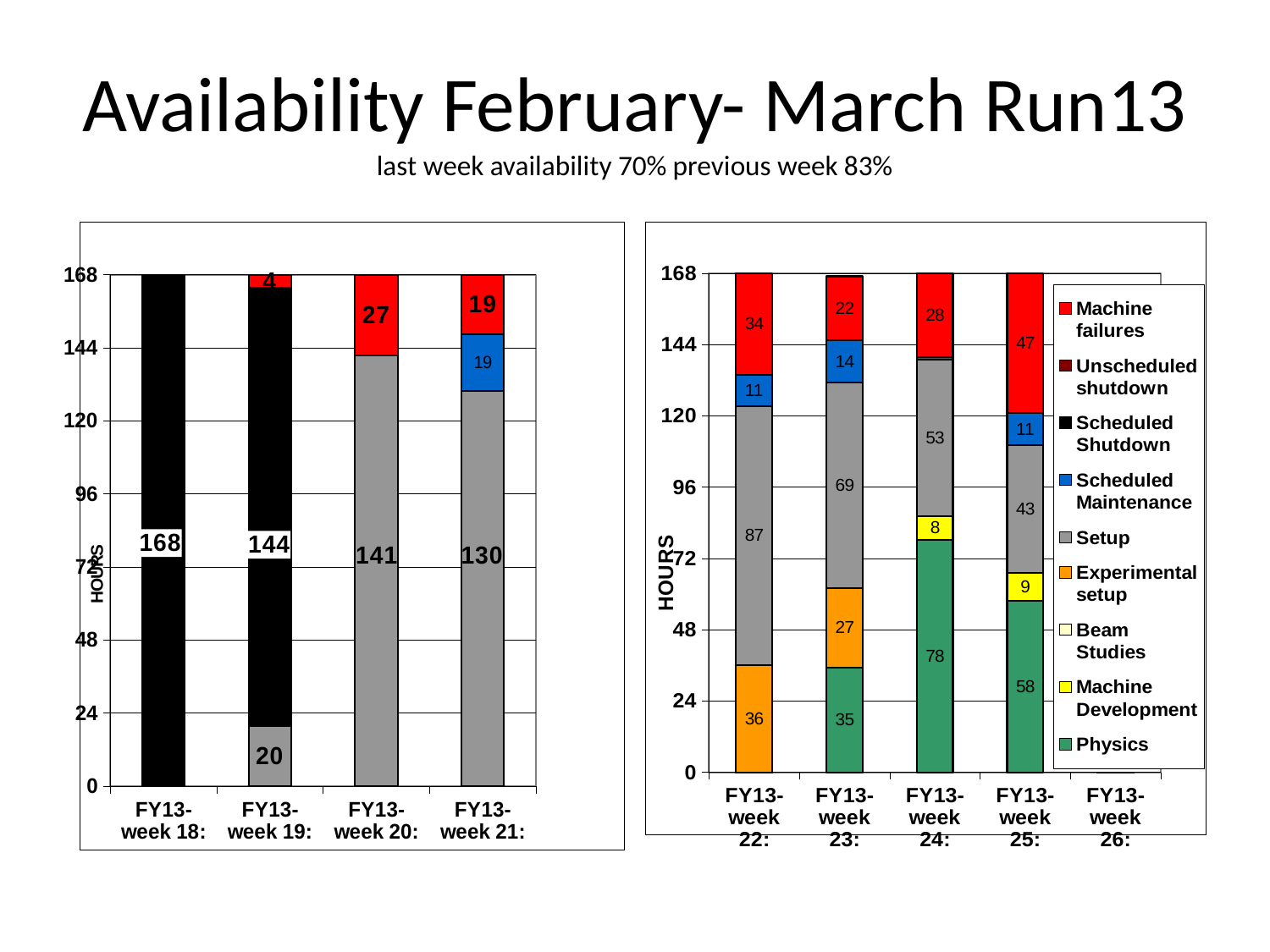
In the left chart, what value is labelled on the gray segment for FY13-week 21? 130 What kind of chart is the left chart? Stacked bar chart In the right chart, how many hours of Physics are shown for FY13-week 24? 78 In the left chart, what value is labelled on the red segment for FY13-week 20? 27 How many weeks are shown on the x axis of the left chart? 4 How many entries does the legend of the right chart list? 9 In the right chart, which week has the most Machine failures hours? FY13-week 25 In the right chart, how many hours of Machine failures are shown for FY13-week 25? 47 In the right chart, what is the total height of the stacked bar for FY13-week 22? 168 In the right chart, what is the difference in Physics hours between FY13-week 24 and FY13-week 25? 20 In the right chart, how many hours of Experimental setup are shown for FY13-week 22? 36 In the right chart, which week has more Setup hours, FY13-week 23 or FY13-week 24? FY13-week 23